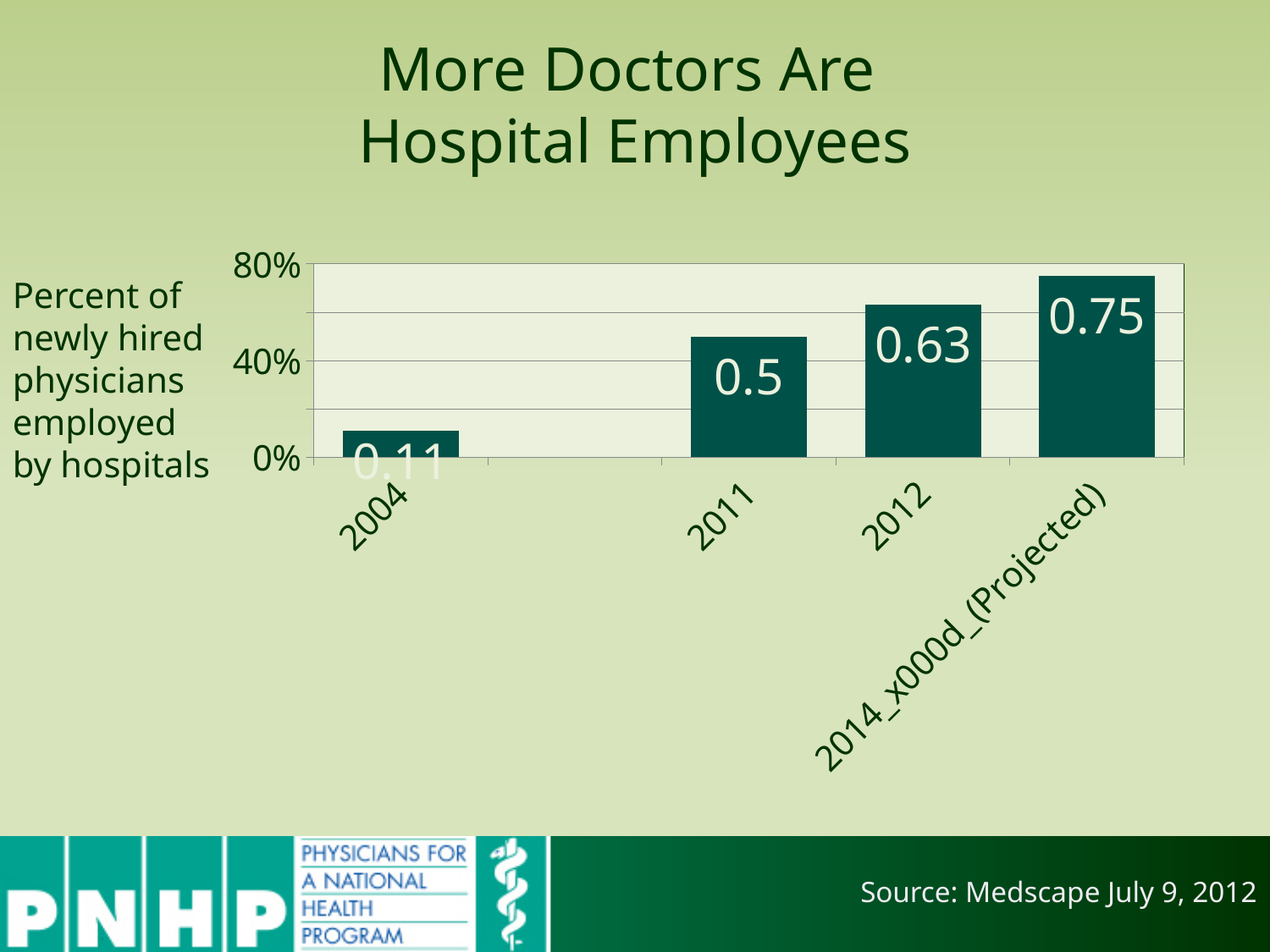
Do the values rise or fall from 2004 to 2014 (Projected)? rise What is the difference between the values for 2012 and 2011? 0.13 How many bars are shown in the chart? 4 What is the value shown for the 2014 (Projected) bar? 0.75 What is the value shown for 2004? 0.11 Is the value for 2004 greater or less than 40%? less Which year has the lowest bar? 2004 Which is larger, the value for 2011 or the value for 2012? 2012 What is the value shown for 2012? 0.63 Which year has the highest bar? 2014 (Projected) What is the value shown for 2011? 0.5 What kind of chart is shown on the slide? bar chart